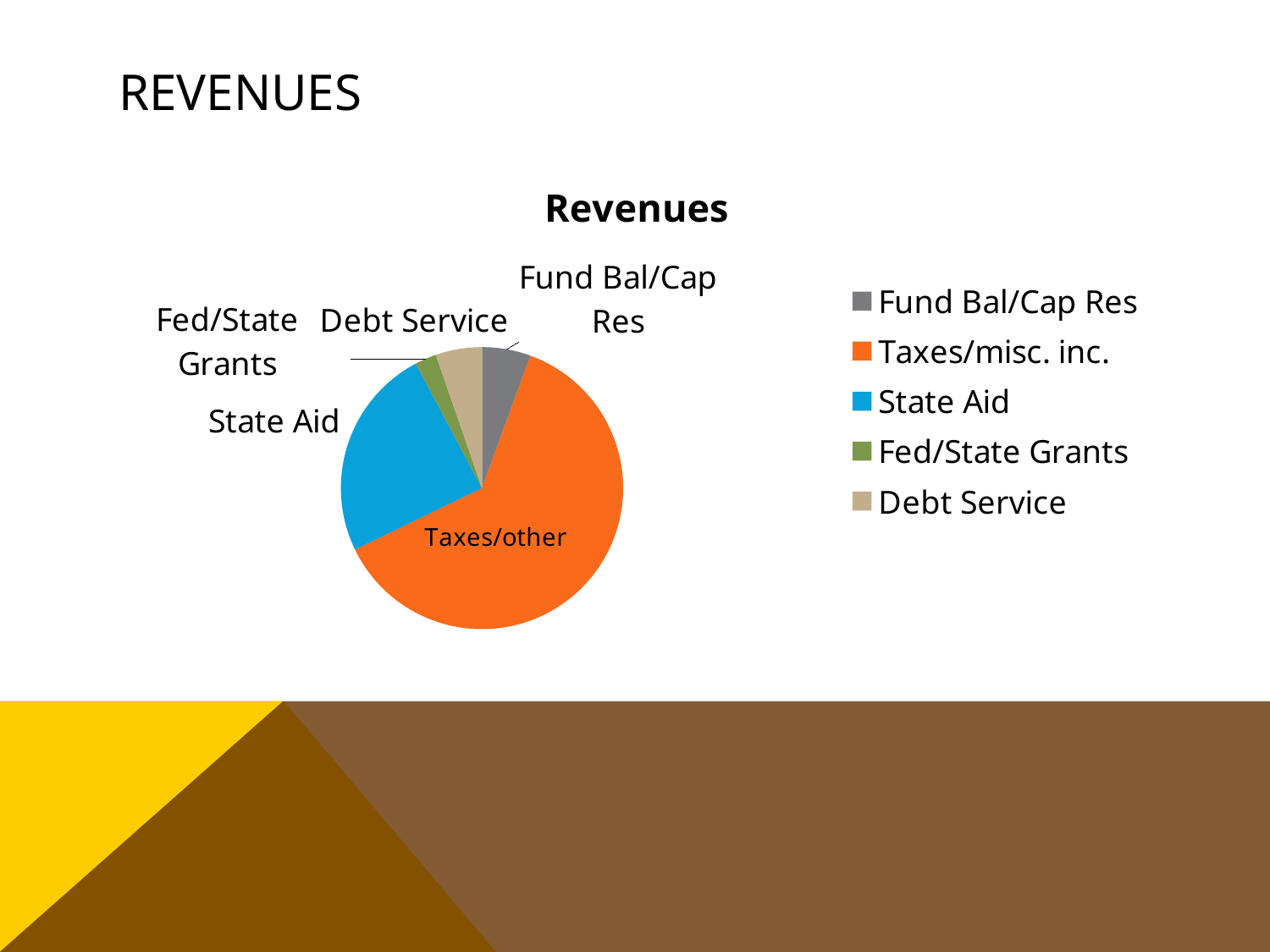
What colour is the State Aid slice in the pie chart? Blue Which is larger, the slice for Fund Bal/Cap Res or the slice for Fed/State Grants? Fund Bal/Cap Res Which is larger, the slice for State Aid or the slice for Taxes/misc. inc.? Taxes/misc. inc. What kind of chart is shown on the slide? Pie chart Which is larger, the slice for State Aid or the slice for Fund Bal/Cap Res? State Aid What is the title of the chart? Revenues How many entries does the legend list? 5 How many slices does the pie chart have? 5 Which category has the largest slice of the pie? Taxes/misc. inc. What label is printed on the orange slice of the pie? Taxes/other